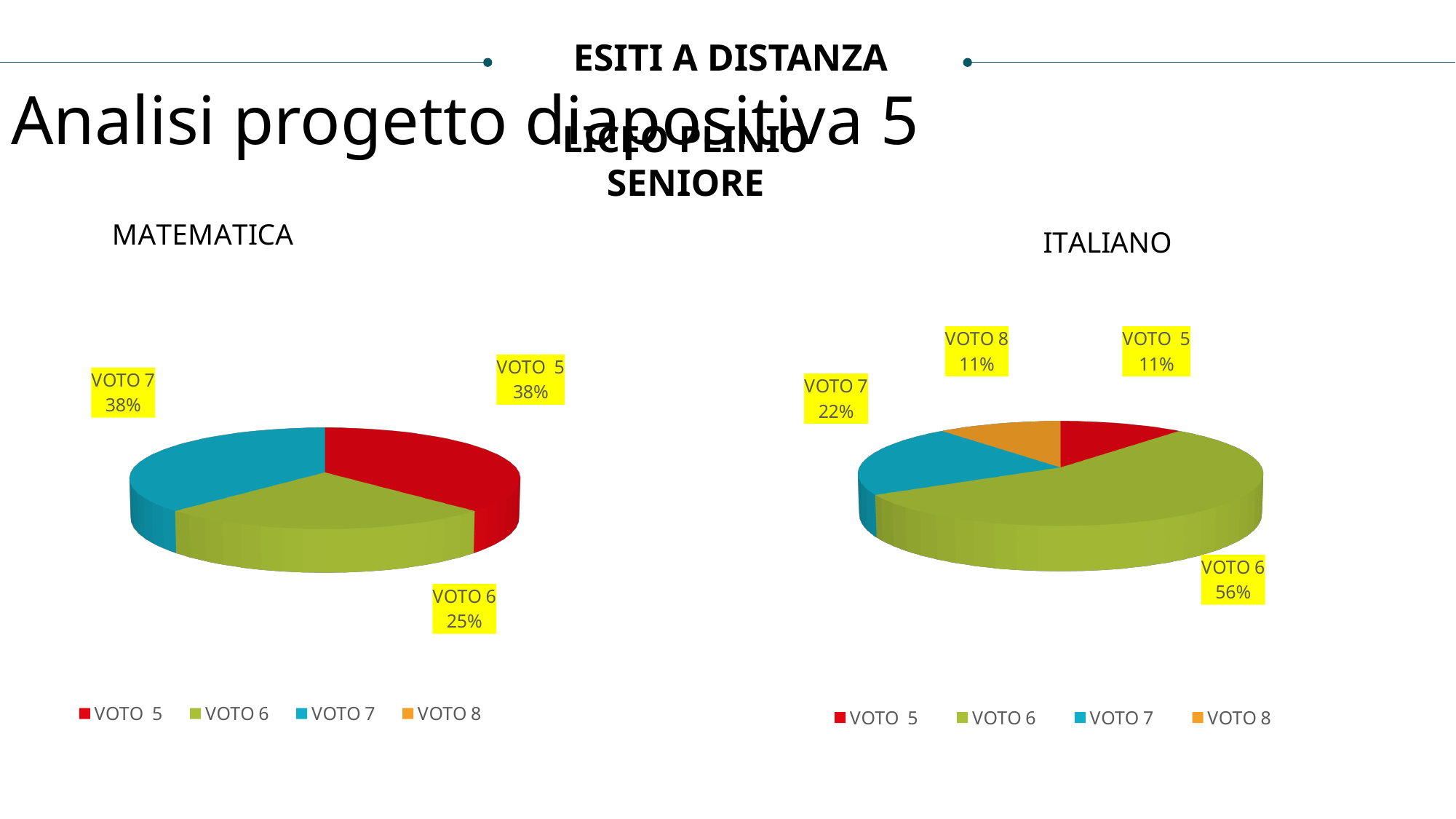
In the MATEMATICA chart, what share does VOTO 7 have? 38% In the ITALIANO chart, what share does VOTO 6 have? 56% In the MATEMATICA chart, what share does VOTO 6 have? 25% Which is larger: the VOTO 5 share in the MATEMATICA chart or the VOTO 5 share in the ITALIANO chart? MATEMATICA In the MATEMATICA chart, what is the difference in percentage points between VOTO 5 and VOTO 6? 13 In the ITALIANO chart, which category has the largest slice? VOTO 6 What kind of chart is the ITALIANO chart? Pie chart In the MATEMATICA chart, which category has the smallest slice? VOTO 6 In the ITALIANO chart, what share does VOTO 8 have? 11% In the ITALIANO chart, what share does VOTO 7 have? 22% In the ITALIANO chart, what is the difference in percentage points between VOTO 6 and VOTO 7? 34 How many entries does the legend of the MATEMATICA chart list? 4